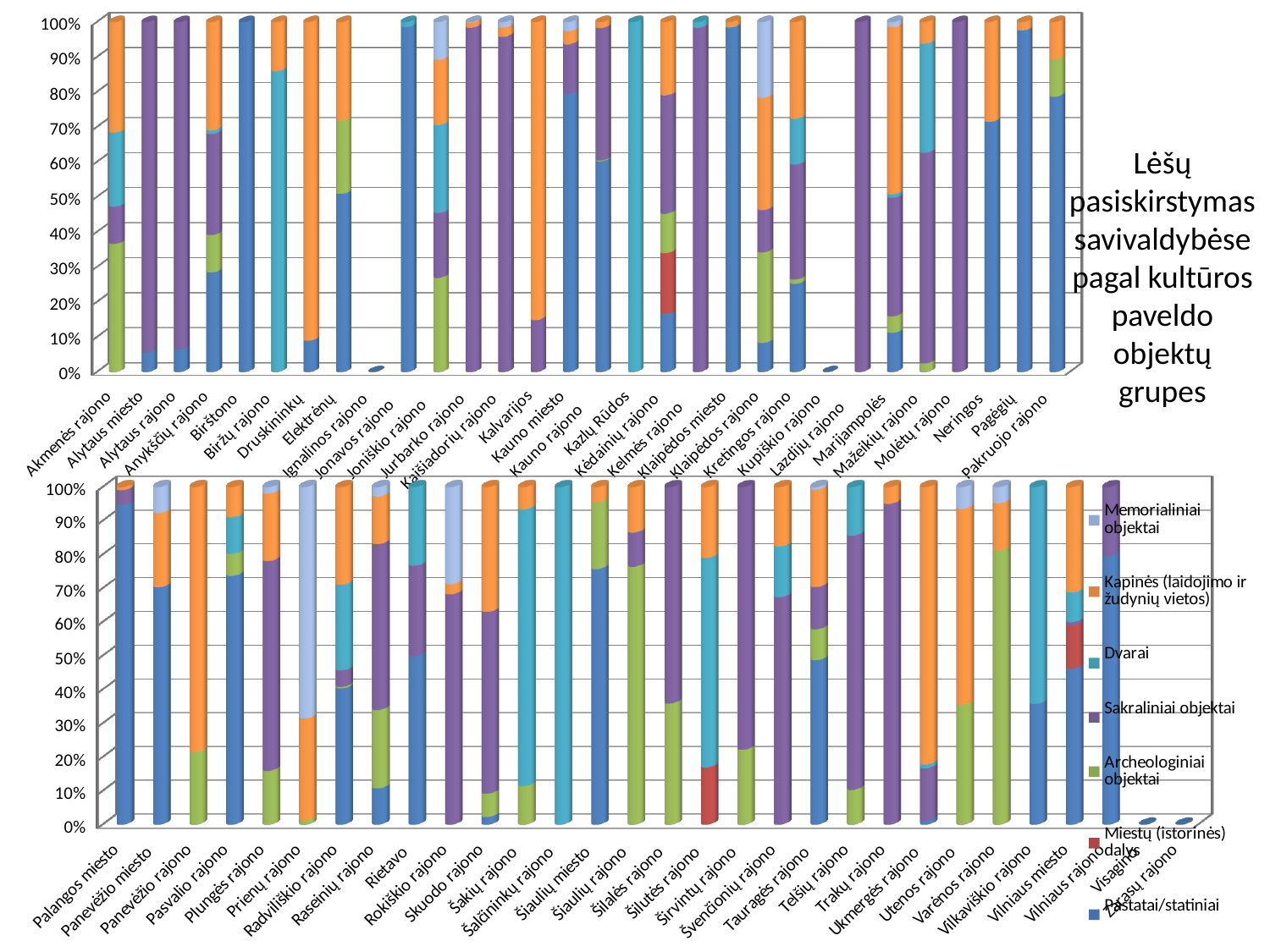
How many municipalities (categories) are shown in the top chart? 30 In the top chart, is the share for Kapinės (laidojimo ir žudynių vietos) in Druskininkų greater or less than 80%? greater In the bottom chart, is the share for Memorialiniai objektai in Prienų rajono greater or less than 60%? greater In the top chart, is the share for Dvarai in Biržų rajono greater or less than 80%? greater How many municipalities (categories) are shown in the bottom chart? 30 In the bottom chart, which single series makes up the entire bar for Šalčininkų rajono? Dvarai How many series does the legend list? 7 What kind of chart is the top chart on the slide? Stacked bar chart What is the title of the chart on the slide? Lėšų pasiskirstymas savivaldybėse pagal kultūros paveldo objektų grupes In the top chart, which has the larger share of Pastatai/statiniai: Biržtono or Akmenės rajono? Birštono